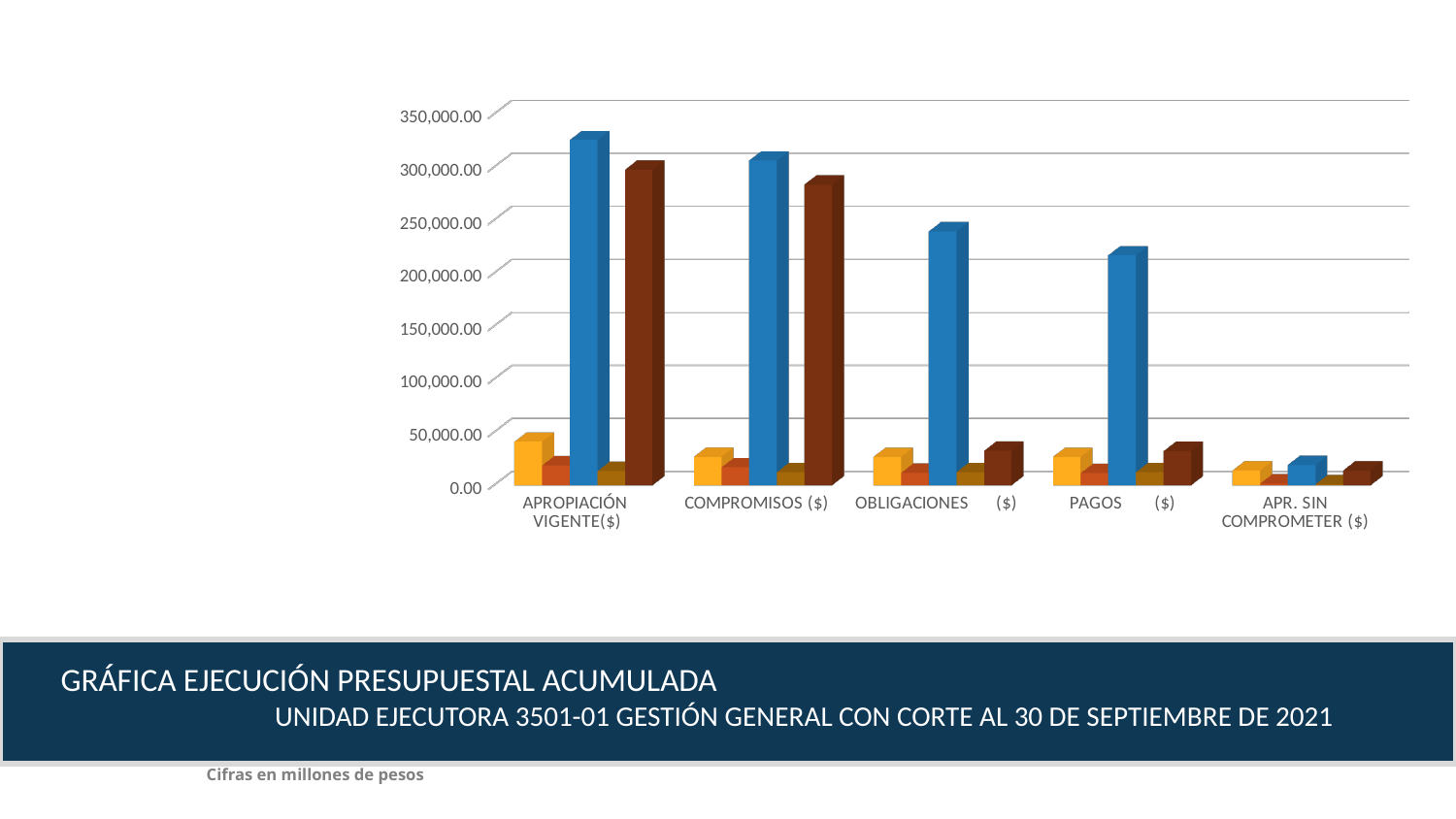
Is the value of the dark brown bar for COMPROMISOS ($) greater or less than 250,000.00? greater What kind of chart is shown on the slide? Bar chart Is the value of the blue bar for OBLIGACIONES ($) greater or less than 200,000.00? greater Which category has the tallest blue bar? APROPIACIÓN VIGENTE($) How many bars are plotted for each category in the chart? 5 Is the value of the blue bar for APR. SIN COMPROMETER ($) greater or less than 50,000.00? less How many categories are shown along the x axis of the chart? 5 Which category has the shortest blue bar? APR. SIN COMPROMETER ($) Which has a larger blue bar, OBLIGACIONES ($) or PAGOS ($)? OBLIGACIONES ($) Do the blue bars rise or fall from left to right across the categories? Fall